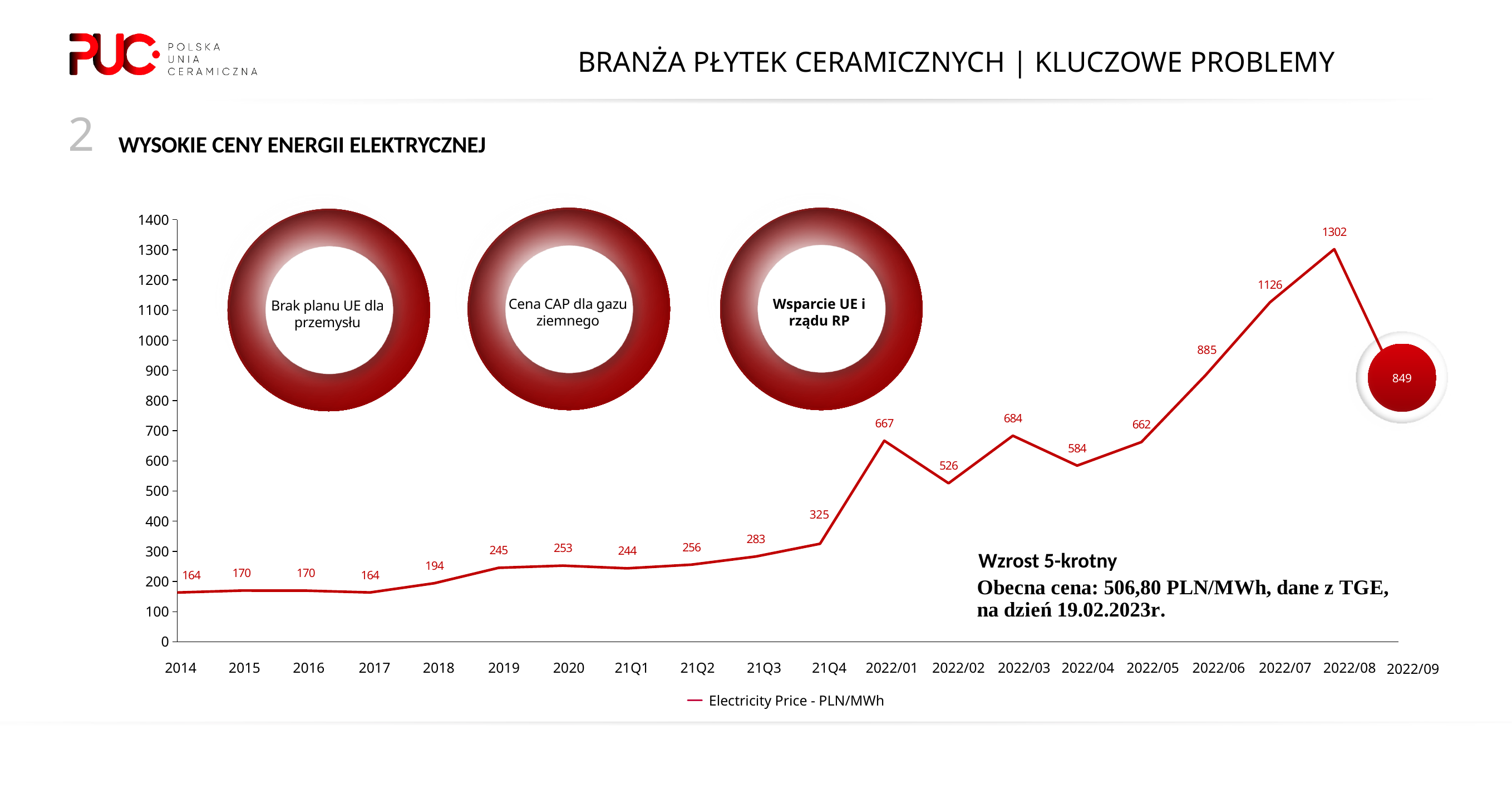
What is the electricity price for 2019? 245 How many series does the legend list? 1 Which period has the highest electricity price? 2022/08 Which is larger, the electricity price in 2022/03 or in 2022/05? 2022/03 What is the electricity price for 2022/09? 849 How many data points are plotted on the chart? 20 What is the name of the series shown in the legend? Electricity Price - PLN/MWh What is the difference between the electricity price in 2022/01 and 21Q4? 342 What kind of chart is shown on the slide? line chart What is the electricity price for 2022/08? 1302 Is the electricity price for 2022/06 greater or less than 800? greater What is the difference between the electricity price in 2022/08 and 2022/07? 176